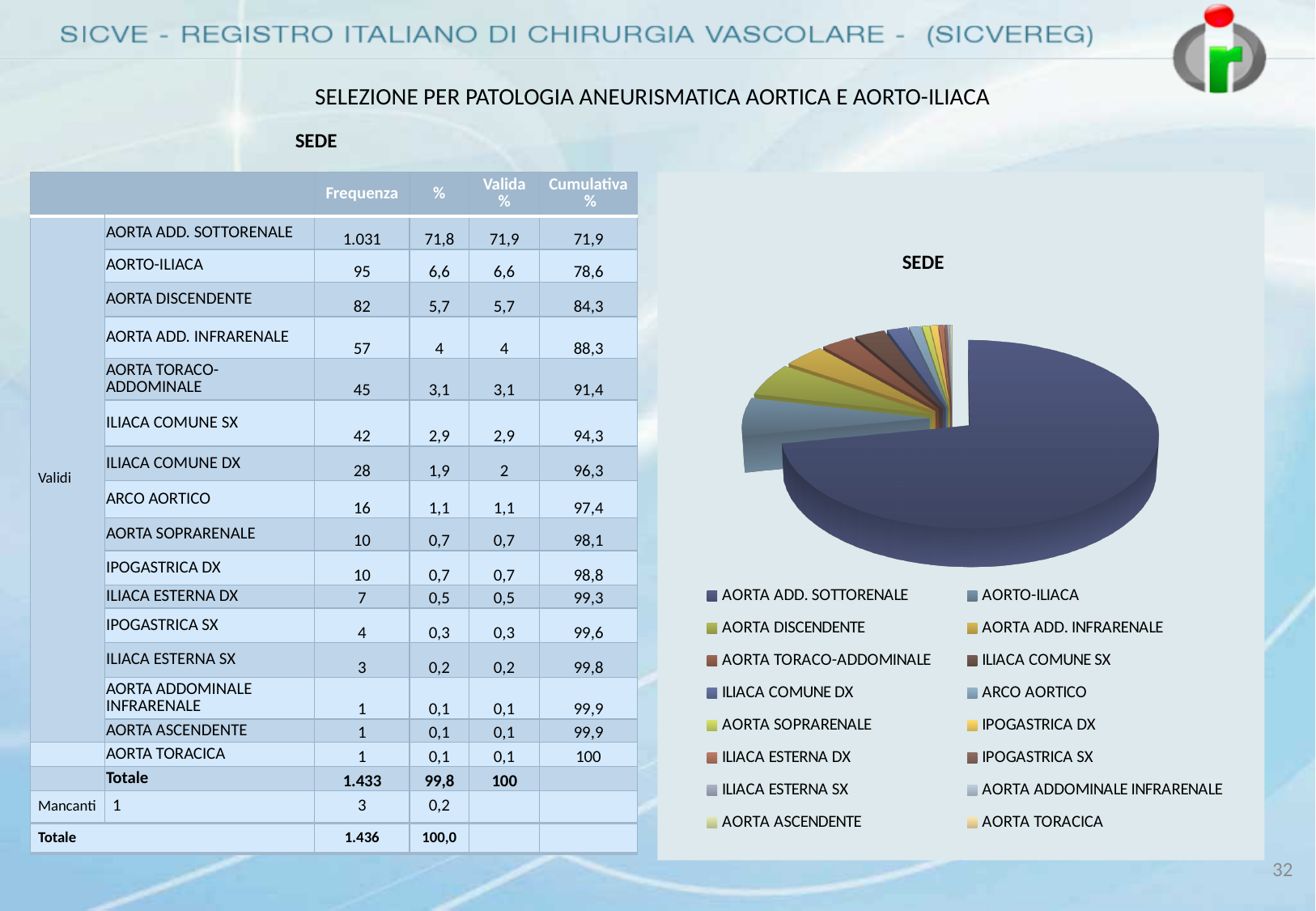
According to the table on the slide, what percentage share does AORTA ADD. SOTTORENALE have? 71,8 What is the title of the pie chart? SEDE According to the table on the slide, what is the frequency for ILIACA COMUNE SX? 42 What kind of chart is shown on the slide? pie chart According to the table on the slide, what is the difference in frequency between AORTA DISCENDENTE and AORTA ADD. INFRARENALE? 25 According to the table on the slide, what is the frequency for AORTO-ILIACA? 95 What colour is the AORTA ADD. SOTTORENALE slice in the pie chart? dark blue According to the table on the slide, what is the frequency for AORTA ADD. SOTTORENALE? 1.031 How many categories does the pie chart's legend list? 16 Which slice is larger in the pie chart, AORTA ADD. SOTTORENALE or AORTO-ILIACA? AORTA ADD. SOTTORENALE According to the table on the slide, what is the total frequency of valid cases (Totale for Validi)? 1.433 Which category has the largest slice in the pie chart? AORTA ADD. SOTTORENALE